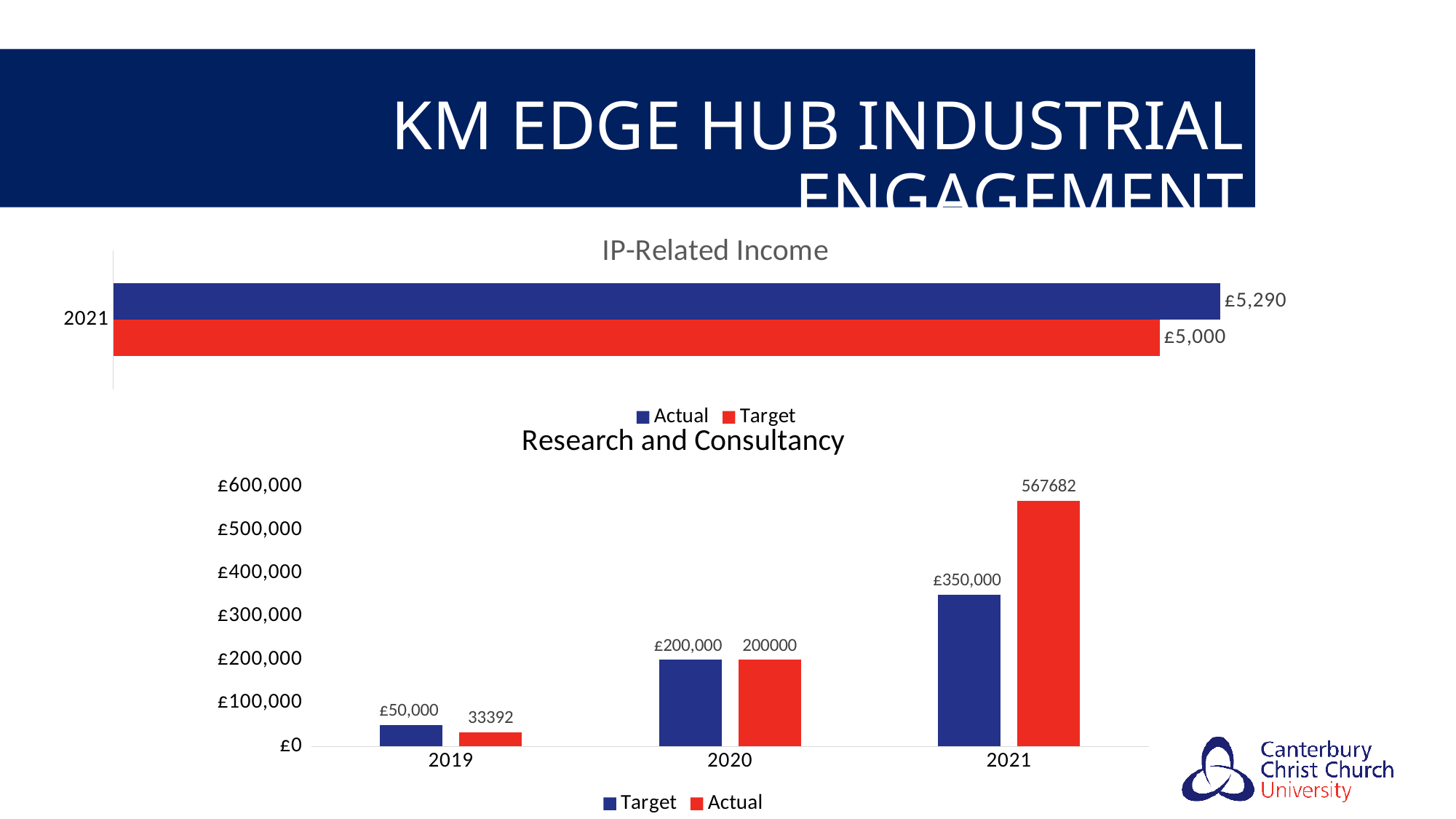
In the Research and Consultancy chart, how many years are shown on the x axis? 3 In the IP-Related Income chart, what is the Actual value for 2021? £5,290 In the Research and Consultancy chart, what is the Target value for 2019? £50,000 How many series does the legend of the Research and Consultancy chart list? 2 In the IP-Related Income chart, which is larger for 2021, Actual or Target? Actual In the IP-Related Income chart, what is the Target value for 2021? £5,000 What kind of chart is the IP-Related Income chart? Bar chart In the IP-Related Income chart, what is the difference between the Actual and Target values for 2021? £290 In the Research and Consultancy chart, does the Target value rise or fall from 2019 to 2021? Rise In the Research and Consultancy chart, what is the Actual value for 2021? 567682 In the Research and Consultancy chart, what is the Actual value for 2019? 33392 In the Research and Consultancy chart, which year has the highest Actual value? 2021